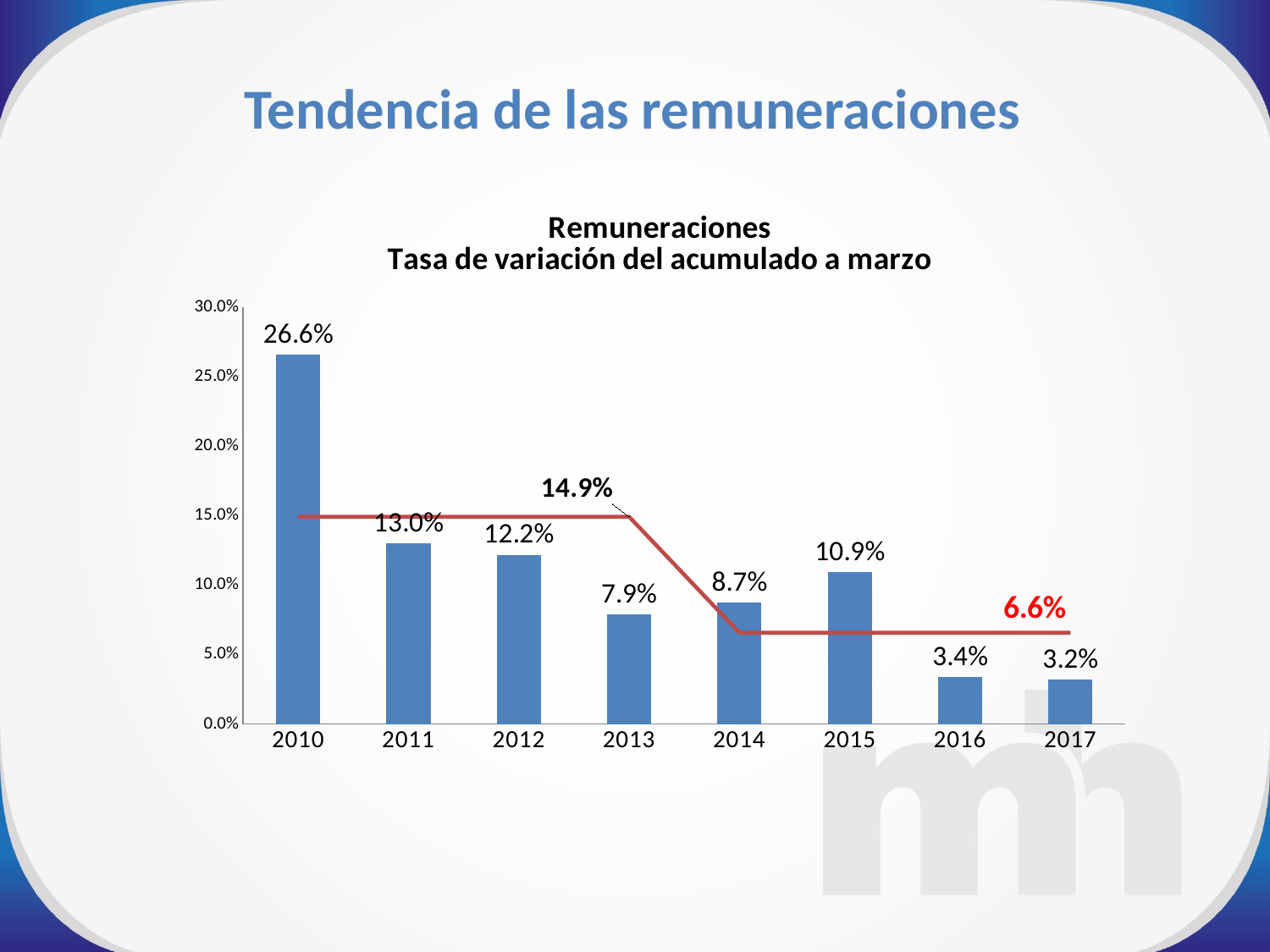
Which year has the lowest value? 2017 Do the bar values generally rise or fall from 2010 to 2017? fall What is the difference between the values for 2011 and 2012? 0.8% What kind of chart is this? combination bar and line chart What is the value for 2010? 26.6% What is the value for 2017? 3.2% What is the value for 2013? 7.9% What value is labelled on the red line for the later years (2014 to 2017)? 6.6% Which year has the highest value? 2010 How many years are shown on the x axis? 8 Which is larger, the value for 2014 or the value for 2015? 2015 Is the value for 2015 greater or less than 10.0%? greater